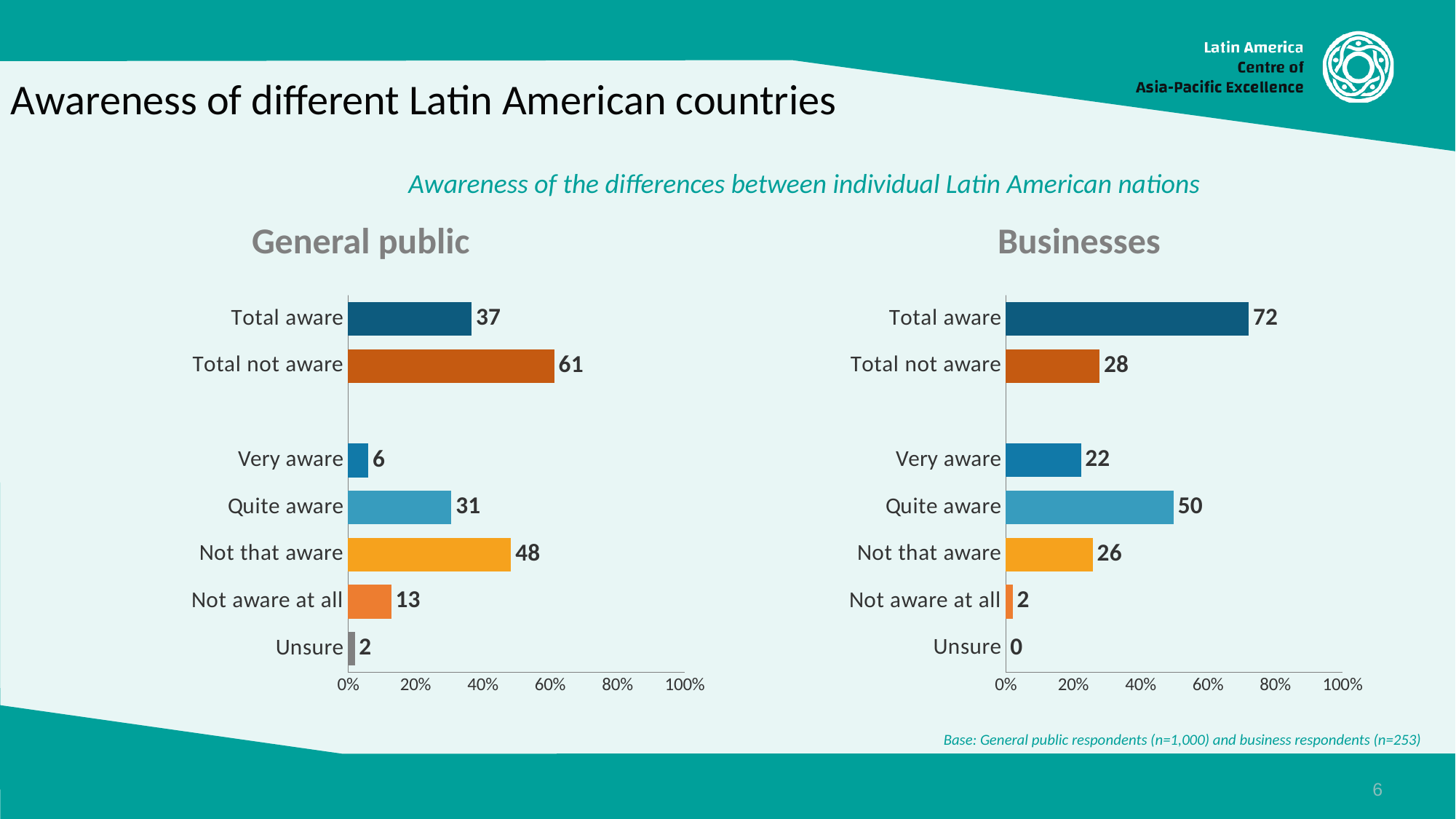
What is the difference between the Total aware values for Businesses and General public? 35 Which is larger: Very aware for General public or Very aware for Businesses? Businesses How many categories are shown in the General public chart? 7 In the General public chart, what is the difference between Not that aware and Quite aware? 17 In the Businesses chart, what is the value for Total aware? 72 In the General public chart, what is the value for Total not aware? 61 In the Businesses chart, is the value for Total aware greater or less than 60%? greater In the General public chart, which of the four awareness levels (Very aware, Quite aware, Not that aware, Not aware at all) has the highest value? Not that aware In the Businesses chart, which category has the lowest value? Unsure In the General public chart, what is the value for Not that aware? 48 In the Businesses chart, what is the value for Quite aware? 50 What type of chart is used for the General public data? Bar chart